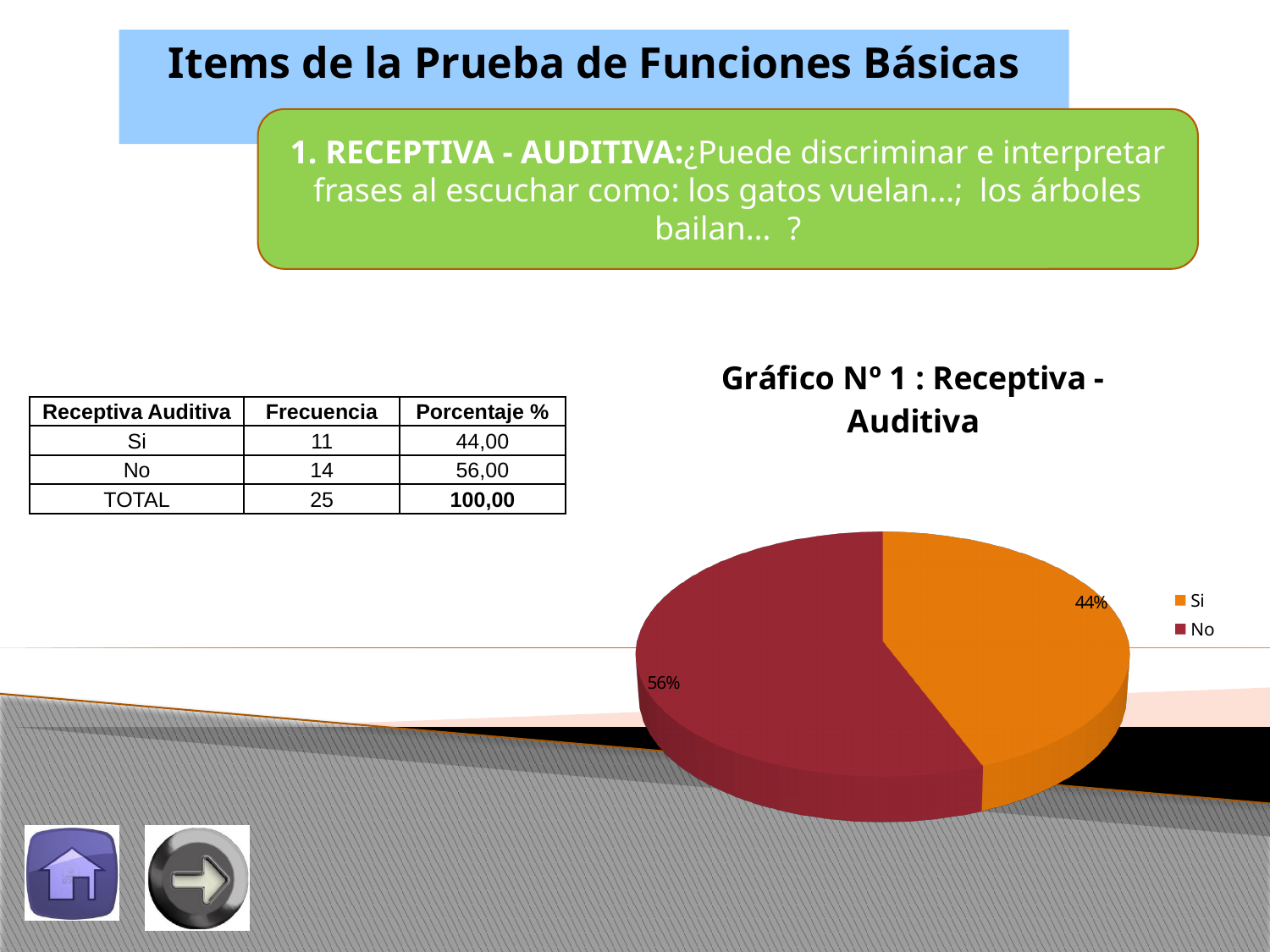
What is the title of the chart? Gráfico Nº 1 : Receptiva - Auditiva What colour is the 'No' slice in the pie chart? dark red What percentage does the 'No' slice show in the pie chart? 56% What is the difference in percentage points between the 'No' slice and the 'Si' slice? 12% How many slices does the pie chart have? 2 Which slice of the pie chart is the smallest? Si How many entries does the chart legend list? 2 Which slice of the pie chart is the largest? No What kind of chart is shown on the slide? pie chart What percentage does the 'Si' slice show in the pie chart? 44% What share of the pie does the 'Si' slice represent? 44% Which is larger in the pie chart, 'Si' or 'No'? No